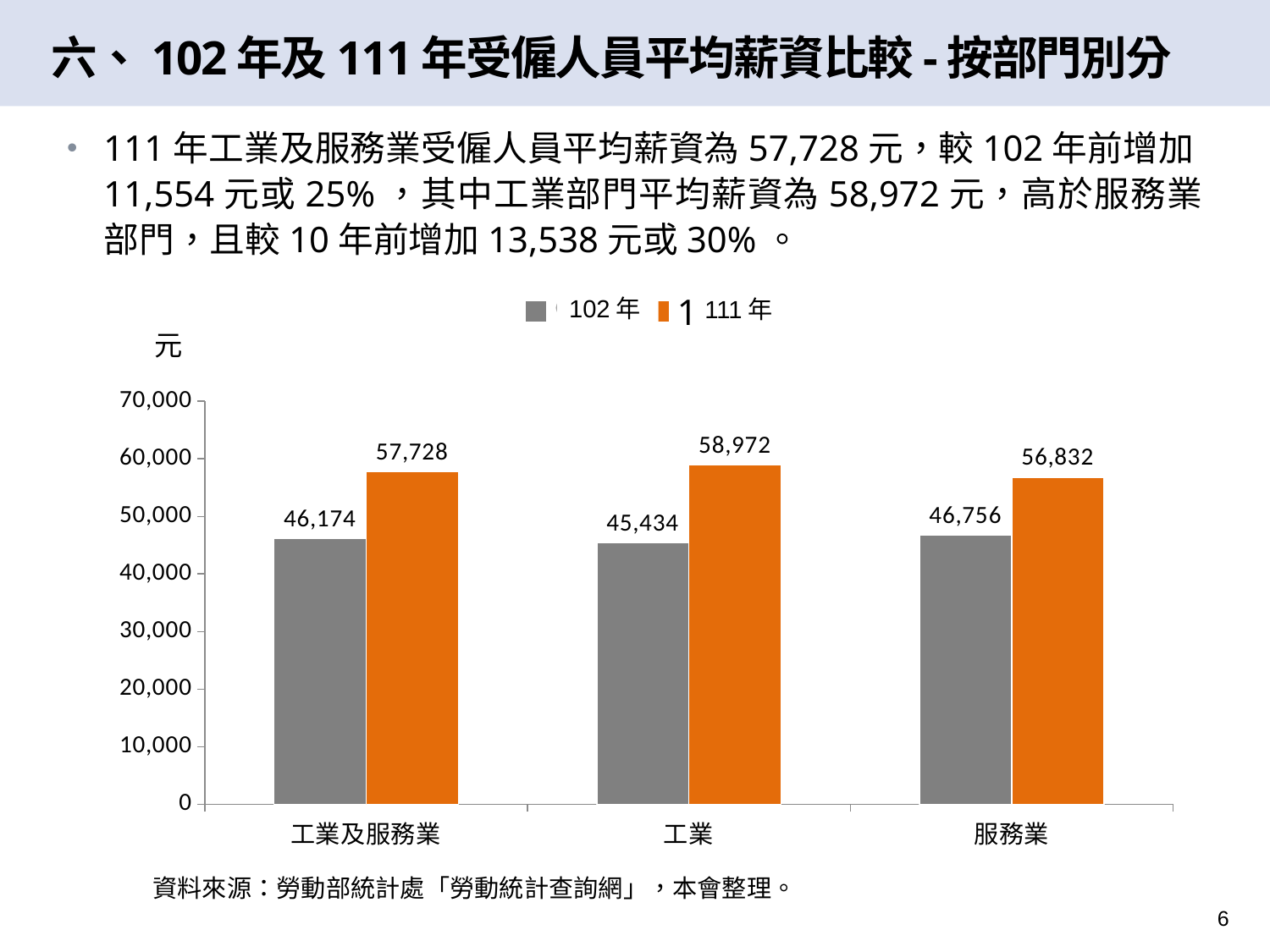
What kind of chart is shown on the slide? bar chart What is the value for 工業 in the 102 年 series? 45,434 How many series does the legend list? 2 What is the difference between the 111 年 and 102 年 values for 工業? 13,538 What is the value for 工業及服務業 in the 111 年 series? 57,728 What is the value for 服務業 in the 111 年 series? 56,832 Which is larger: the 102 年 value for 服務業 or the 102 年 value for 工業? 服務業 Which category has the lowest value in the 102 年 series? 工業 Which category has the highest value in the 111 年 series? 工業 What is the difference between the 111 年 and 102 年 values for 工業及服務業? 11,554 Is the 111 年 value for 服務業 greater or less than 50,000? greater How many categories are shown on the x axis? 3